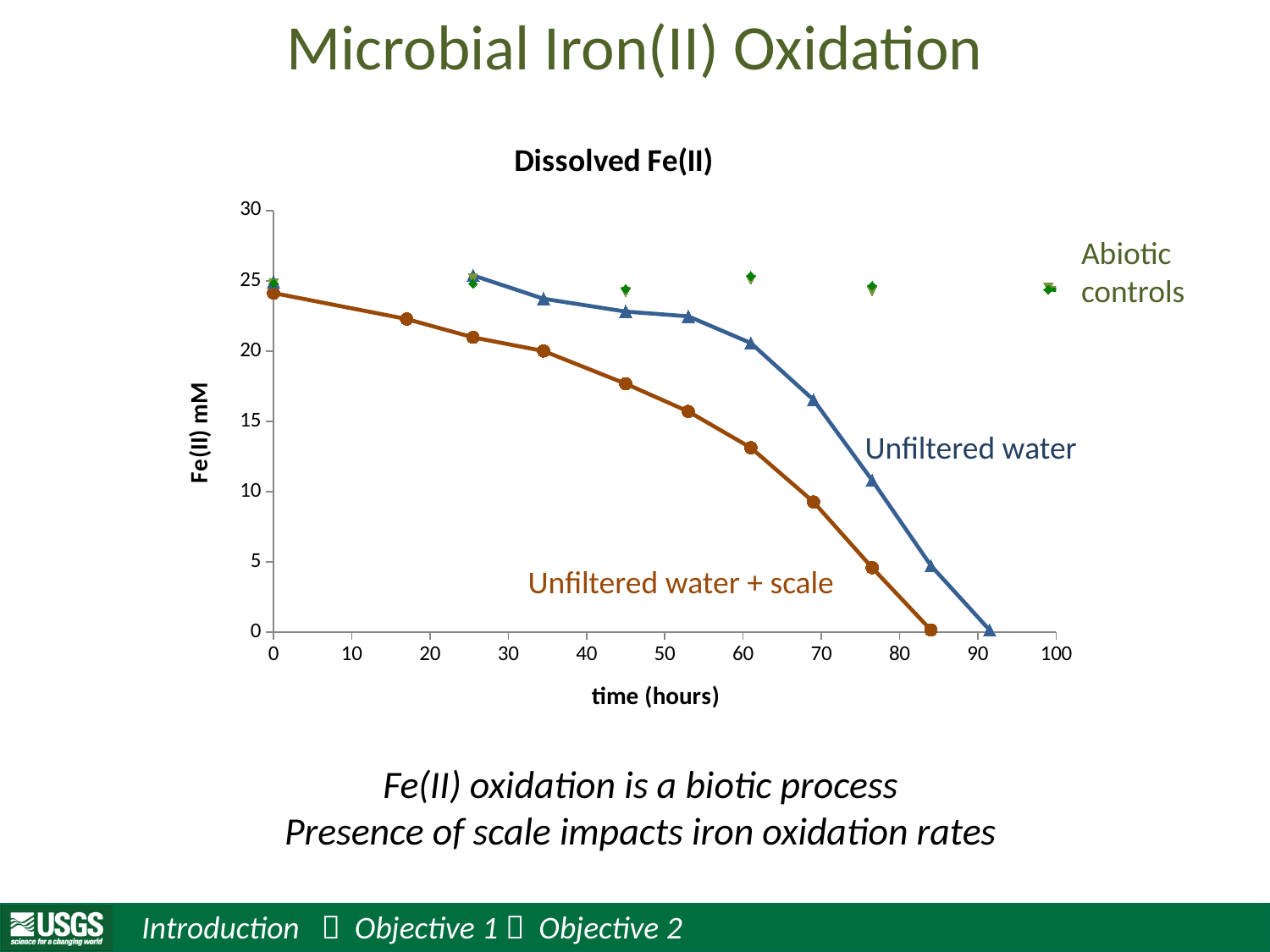
Does the Unfiltered water series rise or fall as time increases? fall Are the Abiotic controls values greater or less than 20 throughout the experiment? greater What is the title of the chart? Dissolved Fe(II) Which series reaches 0 mM Fe(II) first: Unfiltered water or Unfiltered water + scale? Unfiltered water + scale Is the value for Unfiltered water + scale at 0 hours greater or less than 20? greater How many data series are labelled on the chart? 3 At around 60 hours, which series has the higher Fe(II) value: Unfiltered water or Unfiltered water + scale? Unfiltered water Does the Unfiltered water + scale series rise or fall as time increases? fall What type of chart is shown on the slide? line chart Is the value for Unfiltered water at about 77 hours greater or less than 15? less What is the label of the y axis of the chart? Fe(II) mM Which series stays highest across the whole time range? Abiotic controls